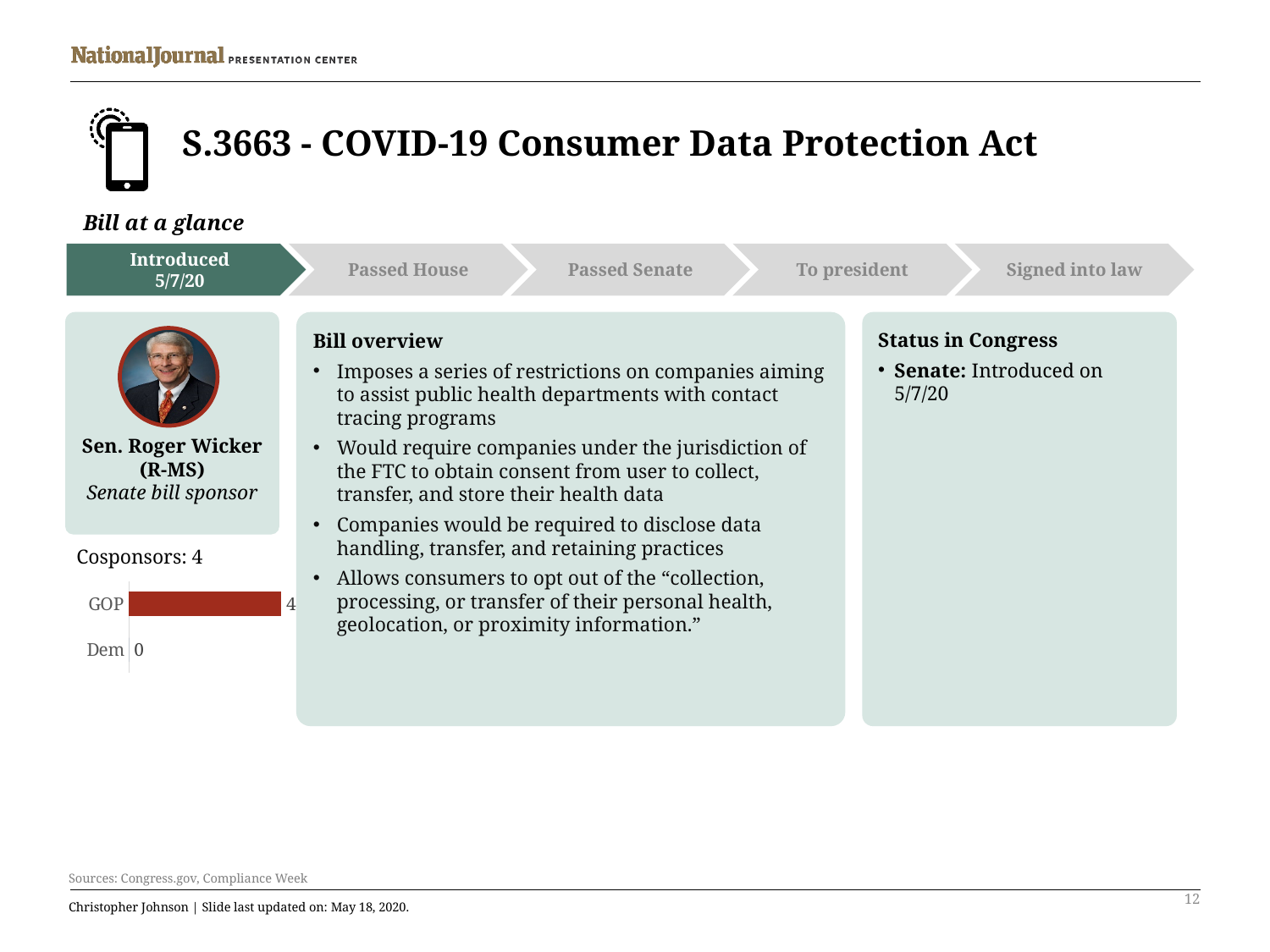
Which is larger in the cosponsors chart, GOP or Dem? GOP What is the value for GOP in the cosponsors chart? 4 Which category has the lowest value in the cosponsors chart? Dem How many categories are shown in the cosponsors chart? 2 What kind of chart is the cosponsors chart? Bar chart What colour is the GOP bar in the cosponsors chart? Red What is the total number of cosponsors shown above the chart? 4 What is the value for Dem in the cosponsors chart? 0 What is the difference between the GOP and Dem values in the cosponsors chart? 4 Which category has the highest value in the cosponsors chart? GOP